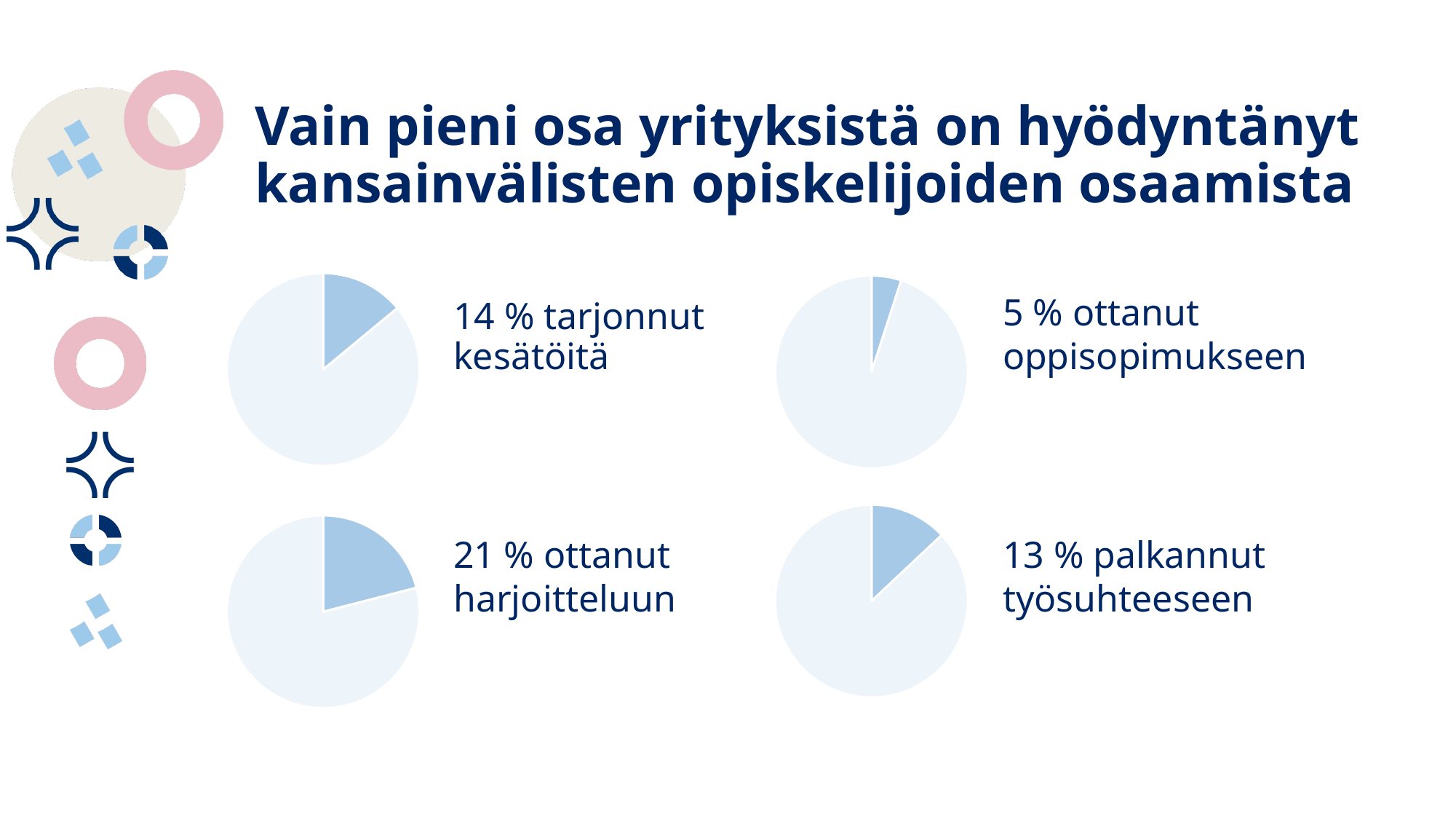
What share of companies has taken students into apprenticeship (ottanut oppisopimukseen), according to the top-right pie chart? 5 % Across the four pie charts, which activity has the lowest share of companies? ottanut oppisopimukseen What type of chart is used on this slide? pie chart What share of companies has offered summer jobs (tarjonnut kesätöitä), according to the top-left pie chart? 14 % What is the difference in percentage points between the share for tarjonnut kesätöitä and the share for palkannut työsuhteeseen? 1 Which is larger: the share for tarjonnut kesätöitä or the share for palkannut työsuhteeseen? tarjonnut kesätöitä How many pie charts are shown on the slide? 4 What share of companies has hired students into employment (palkannut työsuhteeseen), according to the bottom-right pie chart? 13 % What share of companies has taken students into internships (ottanut harjoitteluun), according to the bottom-left pie chart? 21 % What is the difference in percentage points between the share for ottanut harjoitteluun and the share for ottanut oppisopimukseen? 16 Across the four pie charts, which activity has the highest share of companies? ottanut harjoitteluun In the bottom-left pie chart, what share of the pie does the highlighted slice represent? 21 %